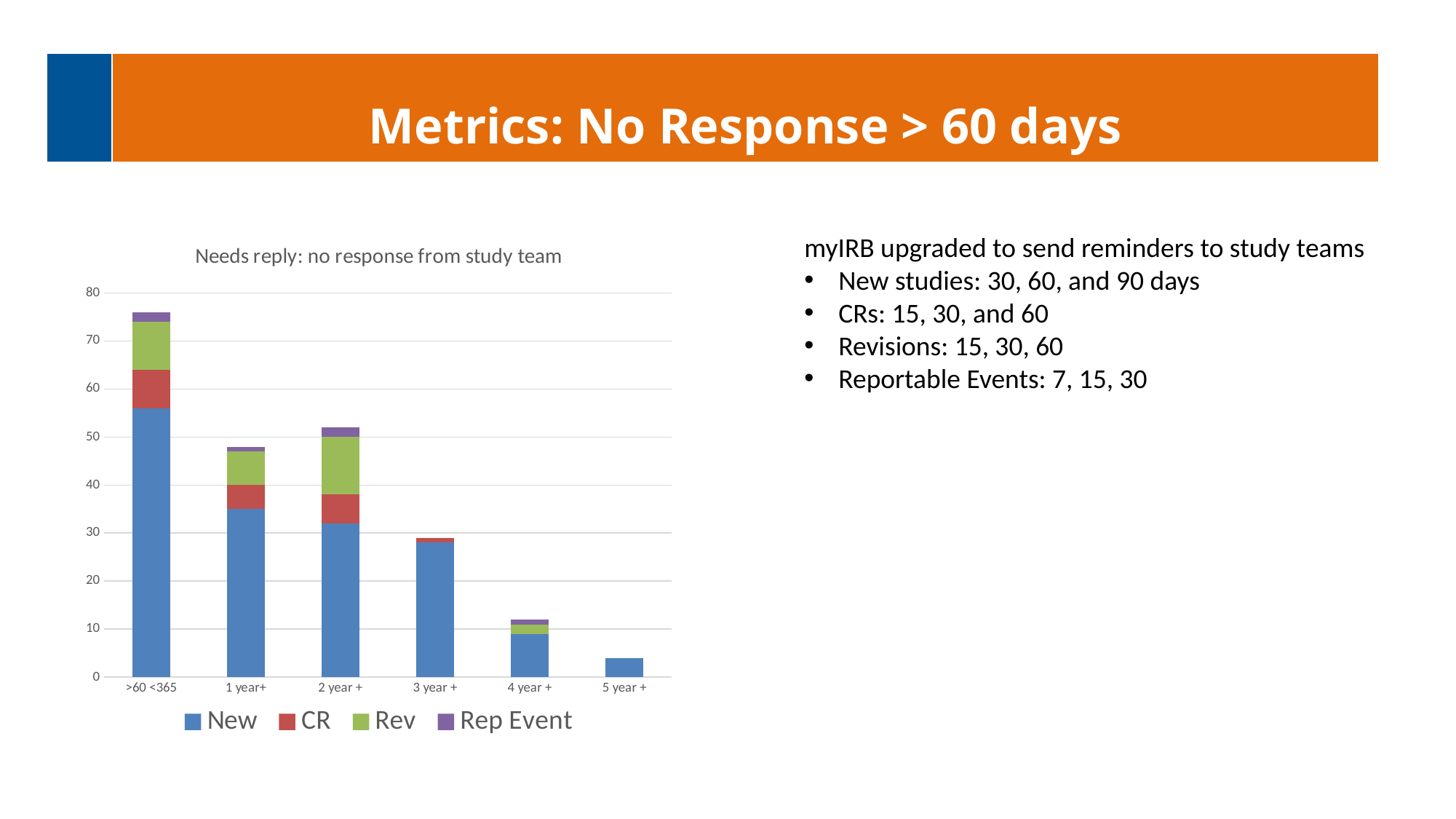
What kind of chart is shown on the slide? Stacked bar chart What is the title of the chart? Needs reply: no response from study team Which category has the tallest stacked bar? >60 <365 Is the New value for >60 <365 greater or less than 50? greater Which series is shown in blue in the chart legend? New How many categories are shown on the x axis of the chart? 6 Is the total stacked value for 4 year + greater or less than 20? less How many series does the chart legend list? 4 Is the total stacked value for 5 year + greater or less than 10? less Which category has the shortest stacked bar? 5 year + Which has the larger total stacked bar, 3 year + or 4 year +? 3 year +